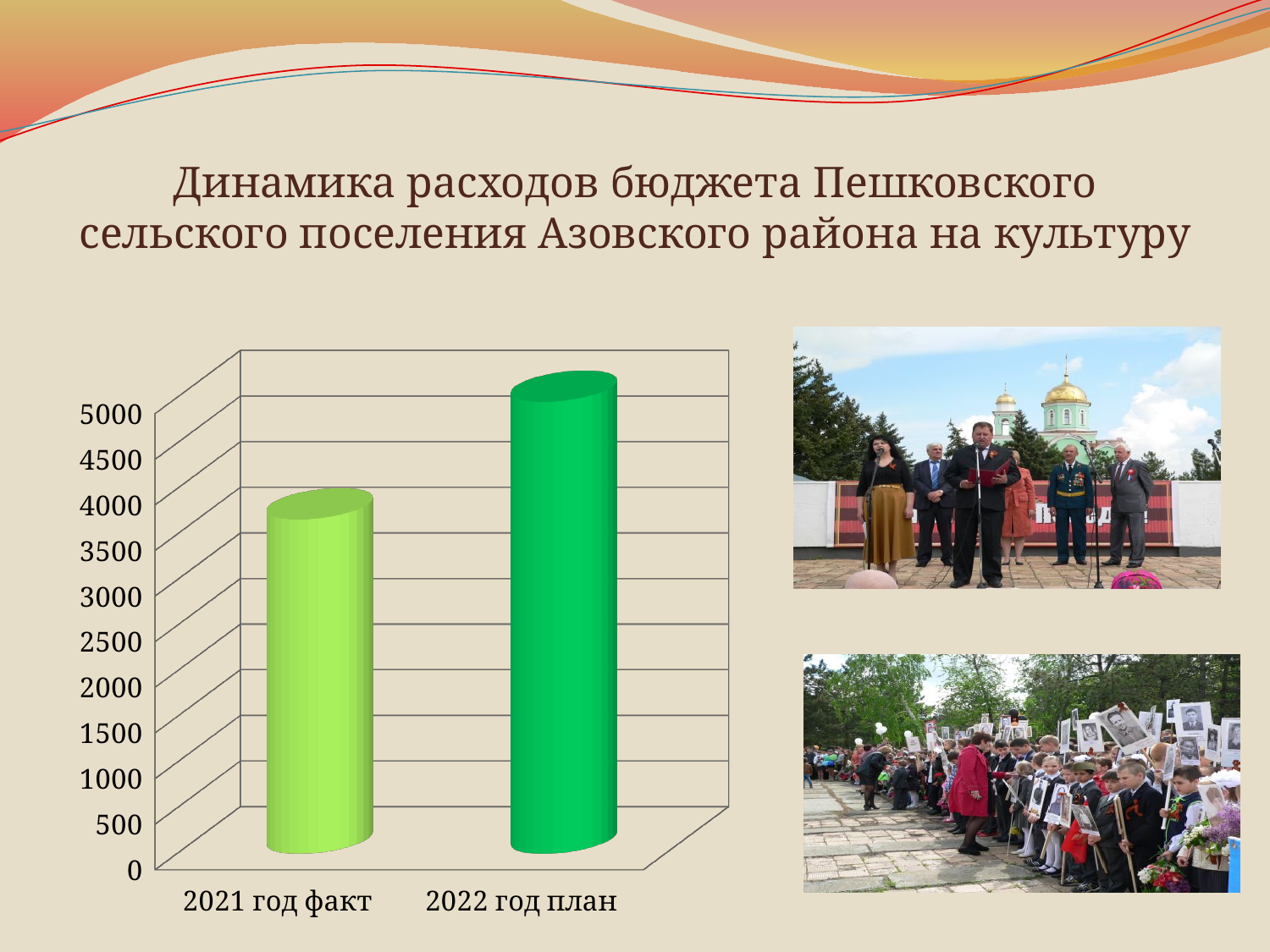
What is the highest value labelled on the vertical axis of the chart? 5000 What kind of chart is shown on the slide? bar chart Is the value for 2021 год факт greater or less than 4500? less Which category has the lowest value in the chart? 2021 год факт How many categories are shown on the x axis of the chart? 2 What is the title of the slide containing the chart? Динамика расходов бюджета Пешковского сельского поселения Азовского района на культуру Do the values rise or fall from 2021 год факт to 2022 год план? rise Which is larger, the value for 2021 год факт or the value for 2022 год план? 2022 год план Is the value for 2022 год план greater or less than 4500? greater Is the value for 2021 год факт greater or less than 3000? greater Which category has the highest value in the chart? 2022 год план